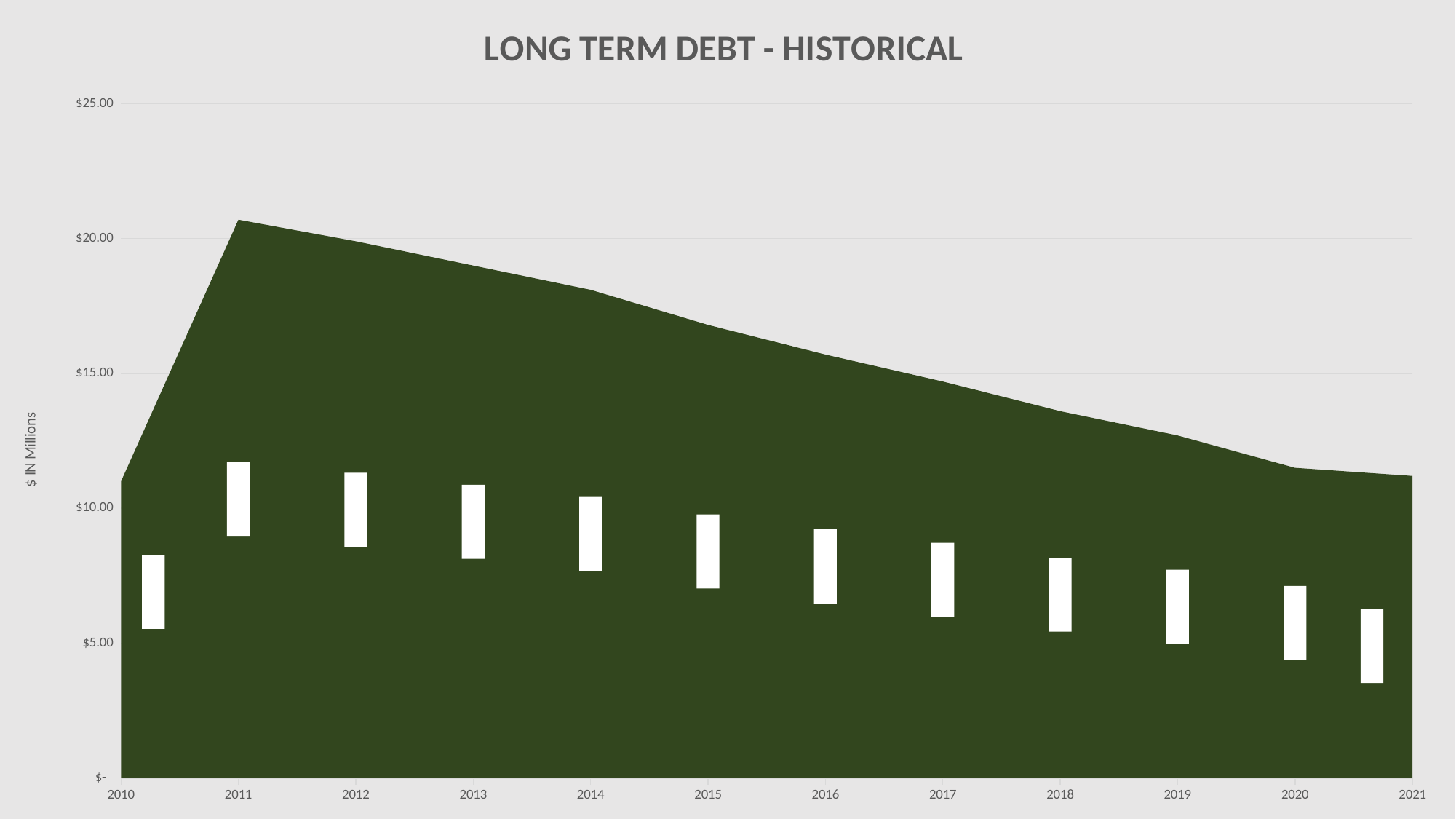
Do the values rise or fall from 2011 to 2021? Fall Is the value for 2011 greater or less than $20.00? greater Is the value for 2017 greater or less than $15.00? less What is the label on the vertical axis of the chart? $ IN Millions What is the title of the chart? LONG TERM DEBT - HISTORICAL How many years are shown along the x axis of the chart? 12 Is the value for 2020 greater or less than $10.00? greater Which year has the highest long term debt value? 2011 Which is larger, the value for 2012 or the value for 2018? 2012 Which is larger, the value for 2015 or the value for 2019? 2015 What kind of chart is shown on the slide? Area chart